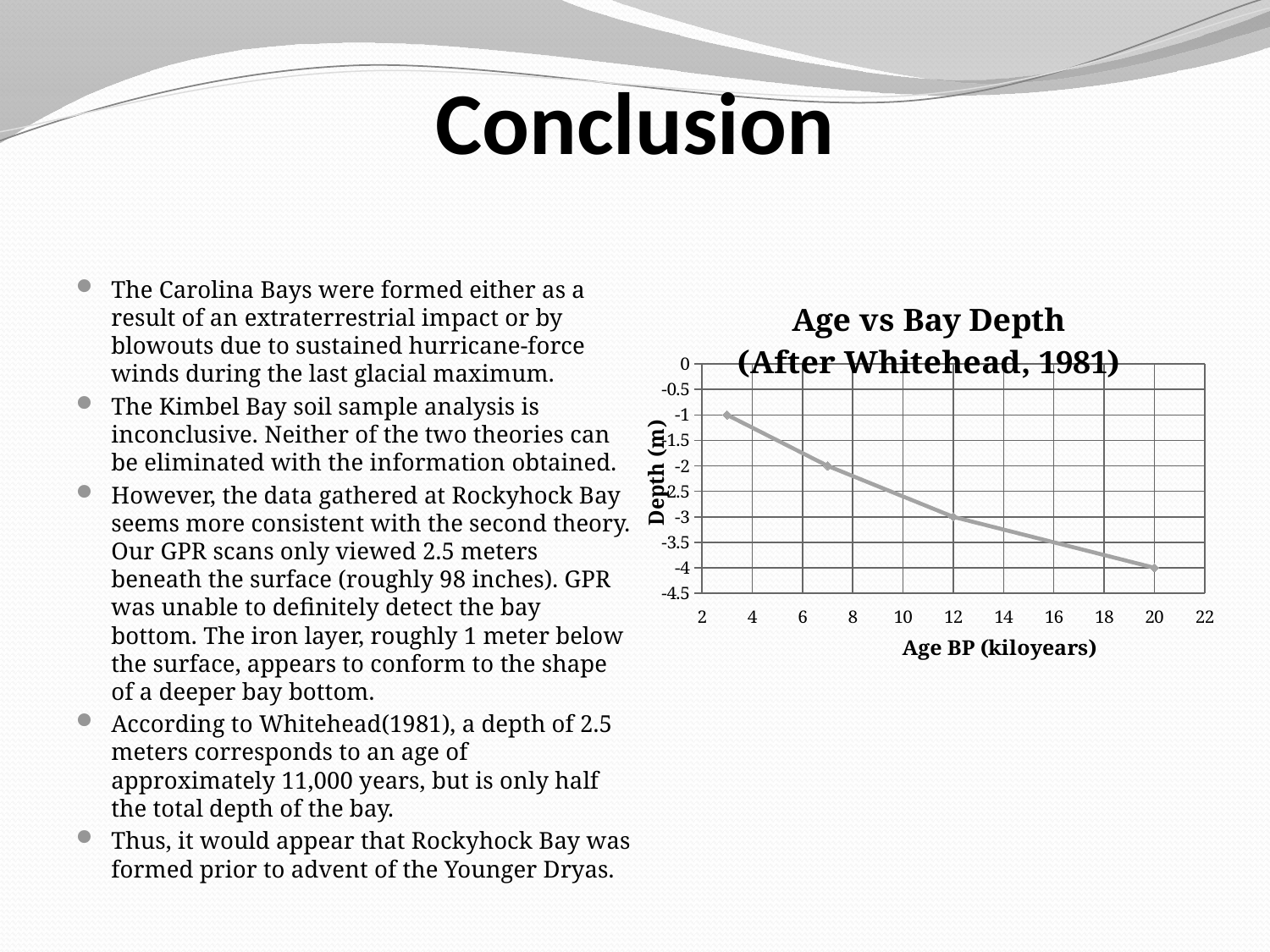
Which data point has the lowest depth value on the chart? the point at 20 kiloyears BP Do the depth values rise or fall as age increases along the x axis? fall Which has the greater (less negative) depth value: the point at 12 kiloyears BP or the point at 20 kiloyears BP? 12 kiloyears BP What is the depth (m) of the leftmost data point on the chart? -1 What is the label of the x axis of the chart? Age BP (kiloyears) What is the title of the chart? Age vs Bay Depth (After Whitehead, 1981) What is the depth (m) at an age of 20 kiloyears BP? -4 What is the depth (m) at an age of 12 kiloyears BP? -3 How many data points are plotted on the chart? 4 What is the difference in depth between the points at 12 and 20 kiloyears BP? 1 m What kind of chart is shown on the slide? line chart Is the depth value at 12 kiloyears BP greater or less than -2.5? less